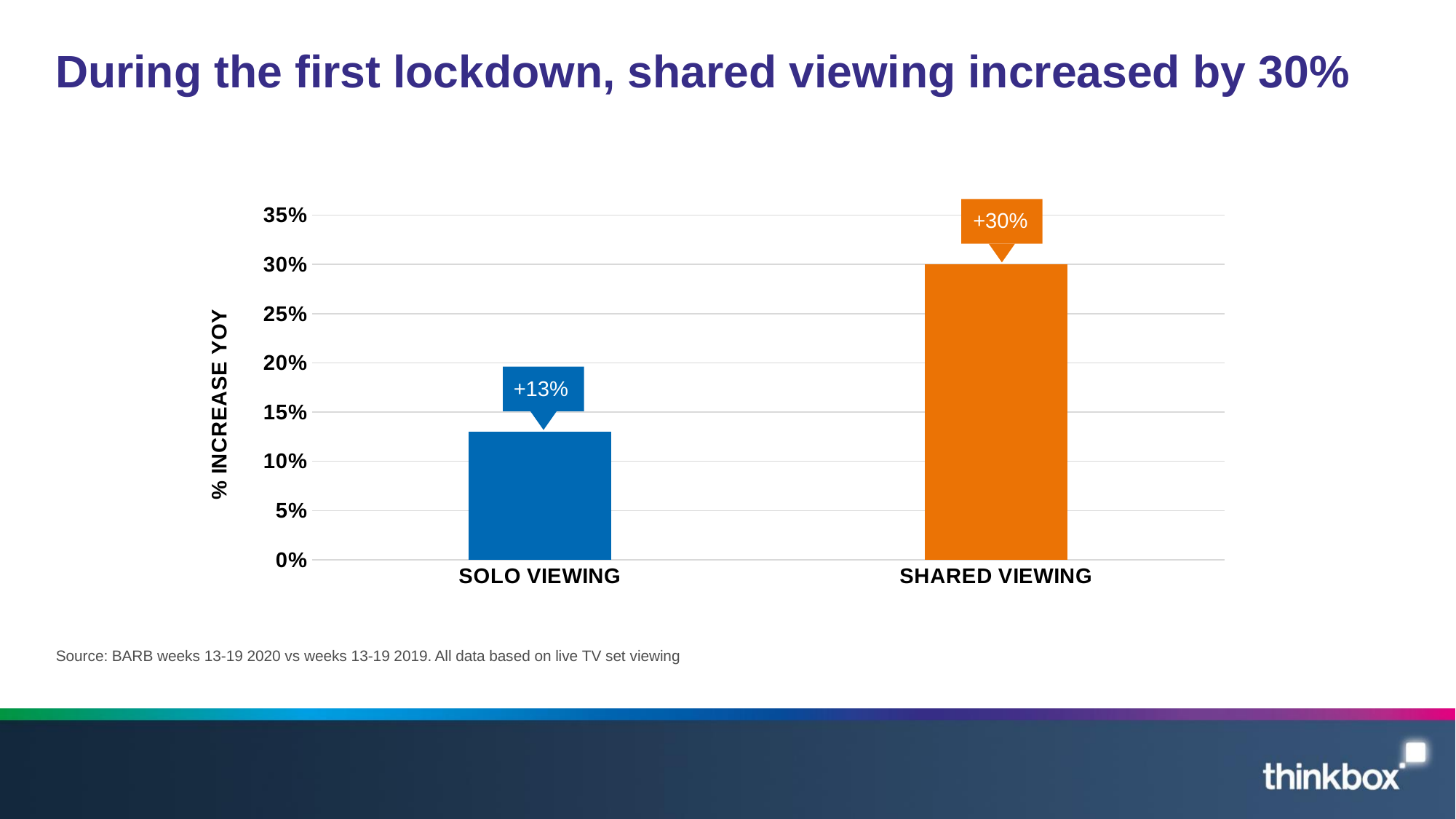
Which category has the highest % increase YOY? Shared Viewing What is the % increase YOY for Shared Viewing? +30% Is the value for Shared Viewing greater or less than 25%? greater What colour is the Shared Viewing bar? Orange Which category has the lowest % increase YOY? Solo Viewing What is the label on the vertical axis of the chart? % INCREASE YOY What is the % increase YOY for Solo Viewing? +13% Is the value for Solo Viewing greater or less than 15%? less Which is larger, the increase for Solo Viewing or for Shared Viewing? Shared Viewing How many categories are shown on the chart? 2 What is the difference in percentage points between the Shared Viewing and Solo Viewing increases? 17 percentage points What kind of chart is shown on the slide? Bar chart